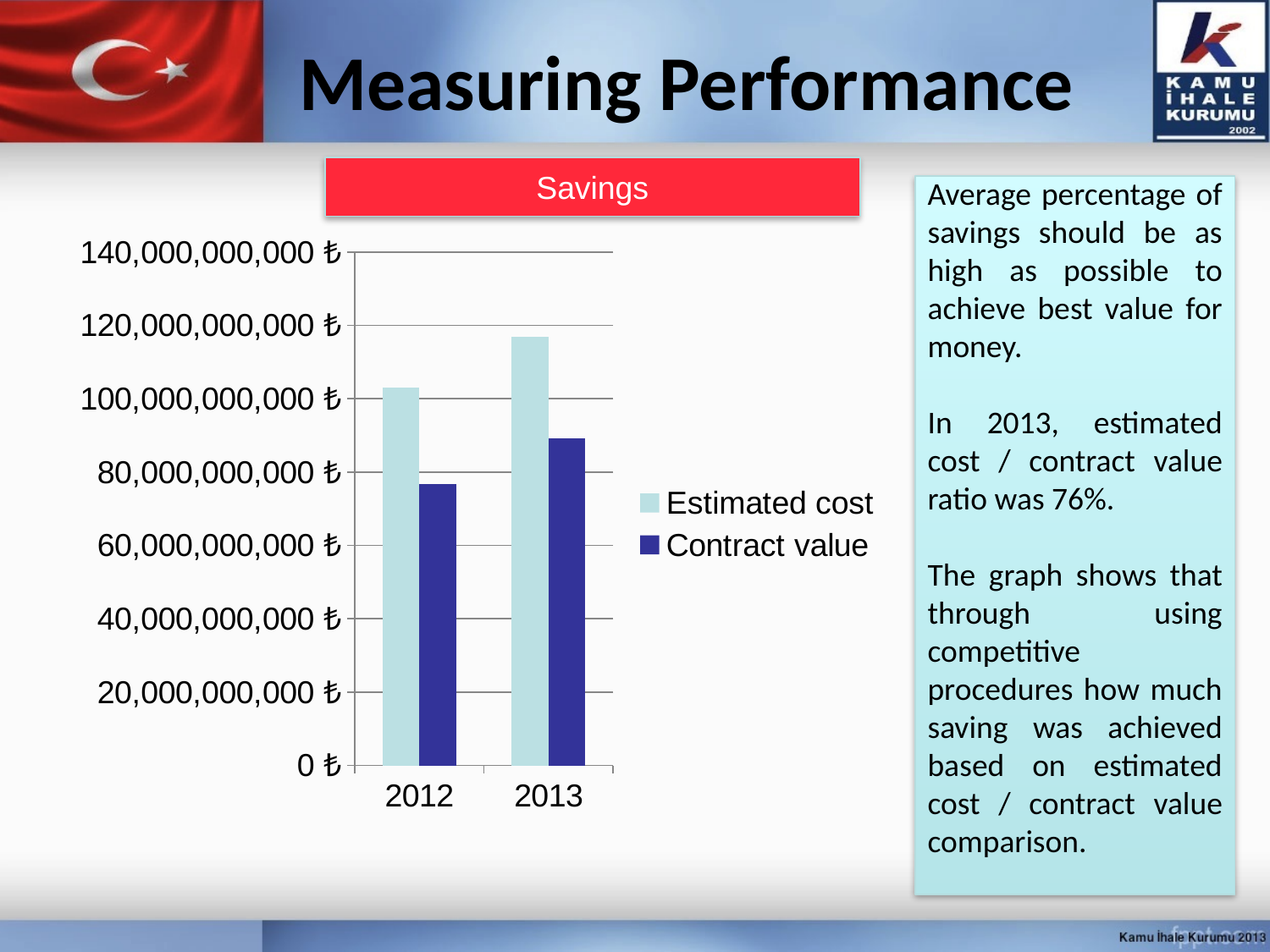
How many series does the chart legend list? 2 How many years are shown on the x axis of the chart? 2 Which bar in the chart is the tallest? Estimated cost in 2013 Which bar in the chart is the shortest? Contract value in 2012 Does the Estimated cost rise or fall from 2012 to 2013? rise Is the Contract value for 2013 greater or less than 100,000,000,000 ₺? less Is the Contract value for 2012 greater or less than 60,000,000,000 ₺? greater Which series is shown in dark blue in the chart? Contract value What kind of chart is shown on the slide? bar chart Which year has the higher Contract value, 2012 or 2013? 2013 What is the title of the chart? Savings Is the Estimated cost for 2013 greater or less than 100,000,000,000 ₺? greater